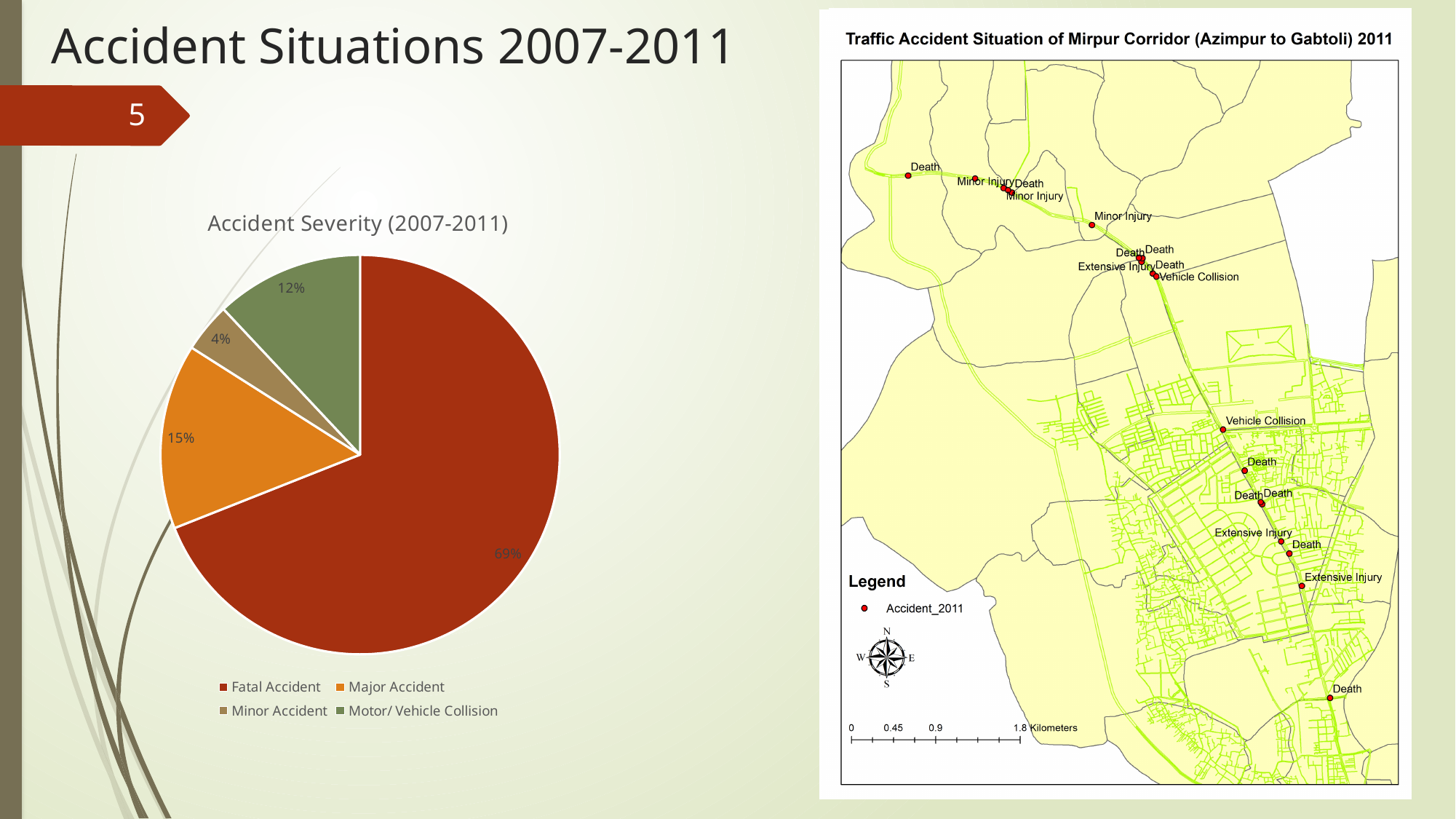
What share of the pie does Fatal Accident have in the Accident Severity (2007-2011) chart? 69% What share of the pie does Motor/ Vehicle Collision have in the Accident Severity (2007-2011) chart? 12% What share of the pie does Minor Accident have in the Accident Severity (2007-2011) chart? 4% In the Accident Severity (2007-2011) pie chart, which is larger: Major Accident or Motor/ Vehicle Collision? Major Accident In the Accident Severity (2007-2011) pie chart, what is the difference in percentage points between Fatal Accident and Major Accident? 54 What type of chart is the Accident Severity (2007-2011) chart? Pie chart Which category has the smallest slice in the Accident Severity (2007-2011) pie chart? Minor Accident What is the title of the pie chart on the slide? Accident Severity (2007-2011) How many categories are shown in the Accident Severity (2007-2011) pie chart? 4 How many entries does the legend of the Accident Severity (2007-2011) pie chart list? 4 Which category has the largest slice in the Accident Severity (2007-2011) pie chart? Fatal Accident